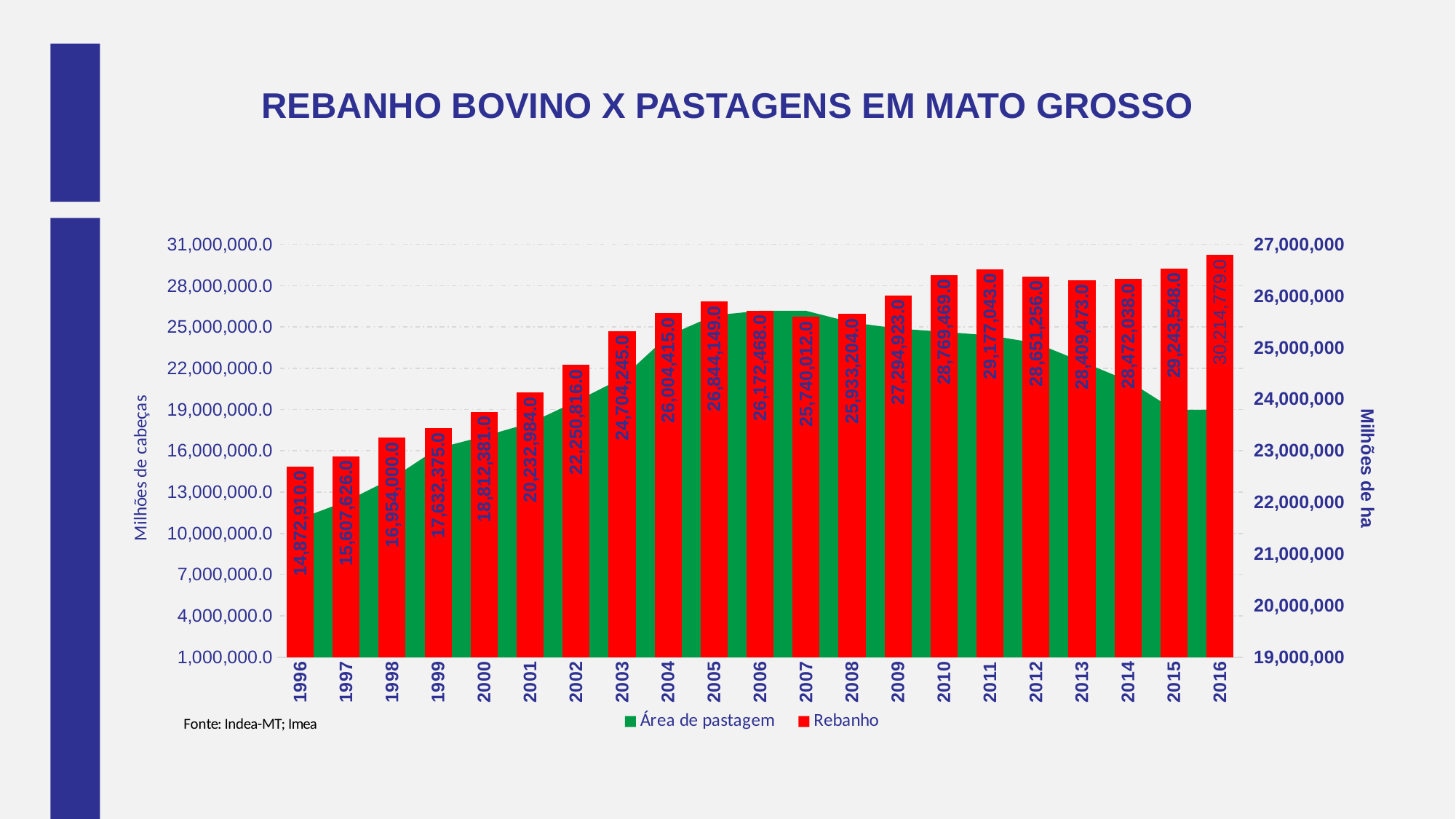
How many series does the legend list? 2 What is the Rebanho value for 2016? 30,214,779.0 Does the Rebanho value rise or fall from 1996 to 2005? rise What is the Rebanho value for 2001? 20,232,984.0 Which year has the highest Rebanho value? 2016 Which year has the larger Rebanho value, 2011 or 2012? 2011 What is the difference between the Rebanho values for 2016 and 1996? 15,341,869.0 How many years are shown on the x axis? 21 Is the Área de pastagem value for 2006 greater or less than 25,000,000 on the right axis? greater Is the Rebanho value for 2003 greater or less than 22,000,000.0? greater What is the Rebanho value for 2008? 25,933,204.0 Which year has the lowest Rebanho value? 1996